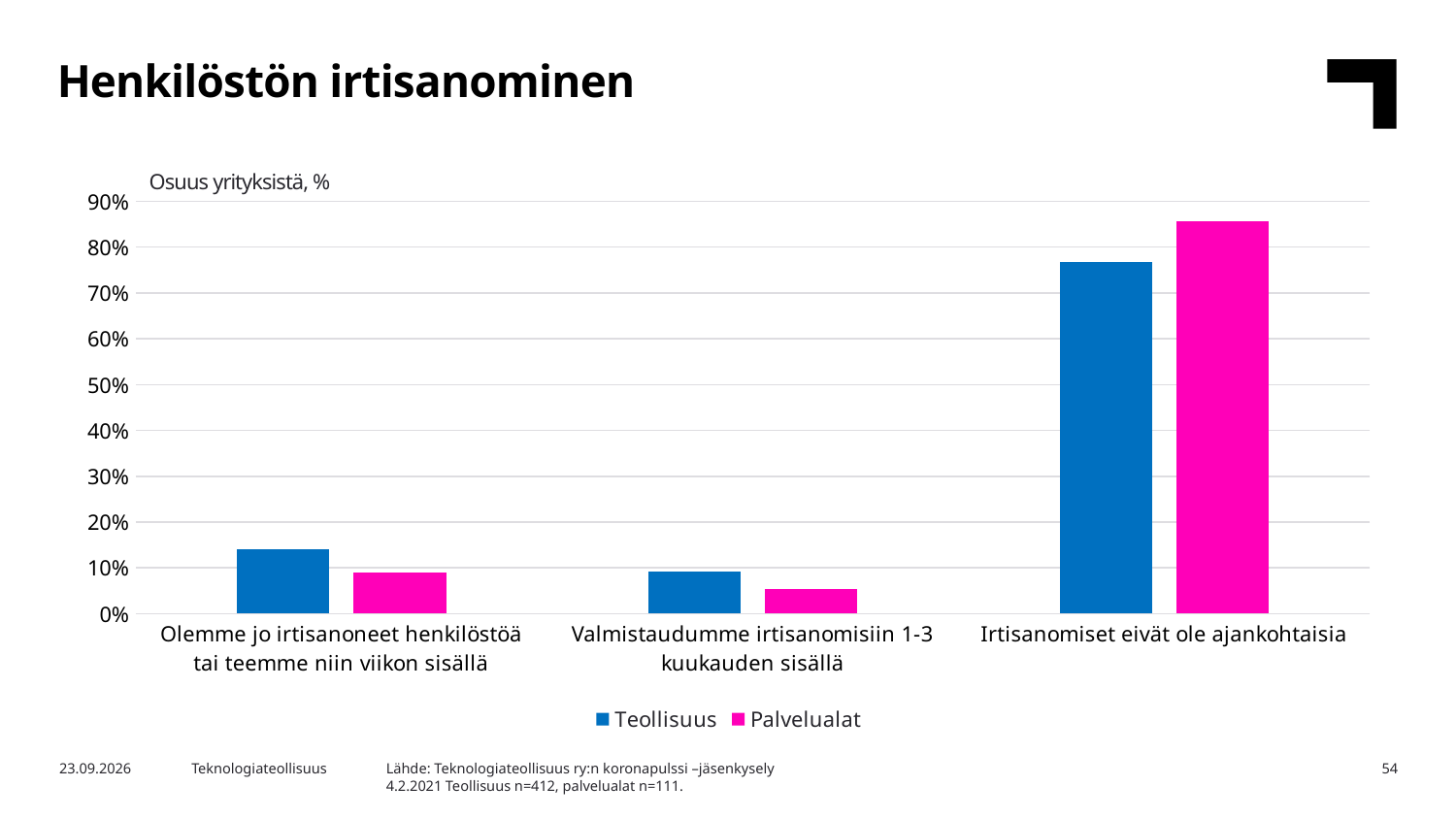
Which category has the highest value for Teollisuus? Irtisanomiset eivät ole ajankohtaisia What kind of chart is shown on the slide? bar chart For 'Olemme jo irtisanoneet henkilöstöä tai teemme niin viikon sisällä', which series has the larger value, Teollisuus or Palvelualat? Teollisuus What is the title of the slide? Henkilöstön irtisanominen Is the Palvelualat value for 'Irtisanomiset eivät ole ajankohtaisia' greater or less than 80%? greater How many series does the legend list? 2 Which category has the lowest value for Palvelualat? Valmistaudumme irtisanomisiin 1-3 kuukauden sisällä What colour represents the Palvelualat series? magenta (pink) How many categories are shown on the x axis? 3 For 'Irtisanomiset eivät ole ajankohtaisia', which series has the larger value, Teollisuus or Palvelualat? Palvelualat Is the Teollisuus value for 'Irtisanomiset eivät ole ajankohtaisia' greater or less than 70%? greater Is the Teollisuus value for 'Olemme jo irtisanoneet henkilöstöä tai teemme niin viikon sisällä' greater or less than 20%? less